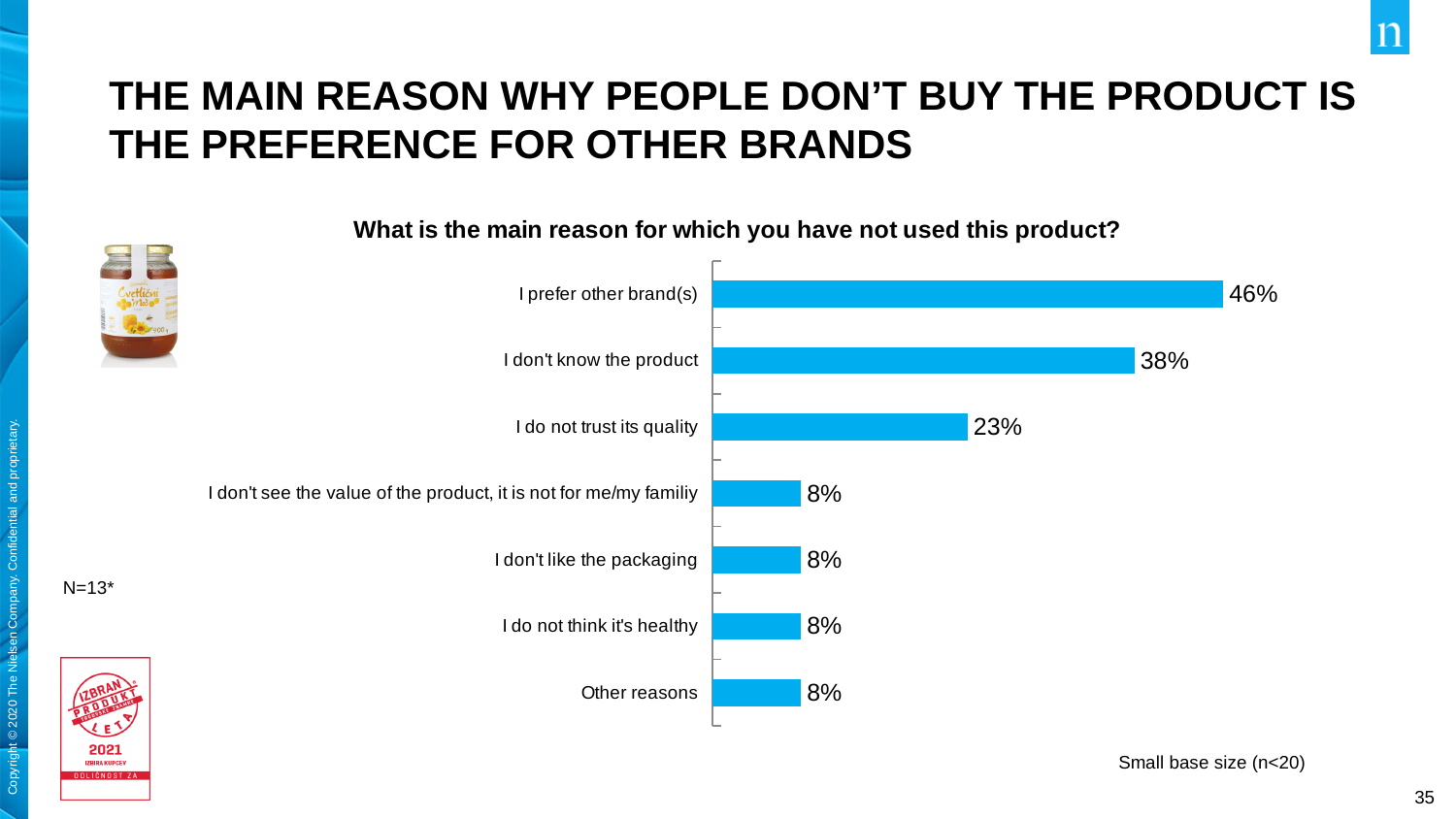
How many reasons are listed in the chart? 7 What is the difference between "I don't know the product" and "I do not trust its quality"? 15 percentage points What type of chart is shown on the slide? Bar chart What is the value for "I don't know the product"? 38% What percentage of respondents said "I prefer other brand(s)"? 46% What is the value for "I don't like the packaging"? 8% Which is larger: "I do not trust its quality" or "I do not think it's healthy"? I do not trust its quality Which reason has the highest percentage? I prefer other brand(s) What question is the chart titled with? What is the main reason for which you have not used this product? What percentage is shown for "I do not trust its quality"? 23% How many reasons share the lowest value of 8%? 4 What is the difference between "I prefer other brand(s)" and "I don't know the product"? 8 percentage points